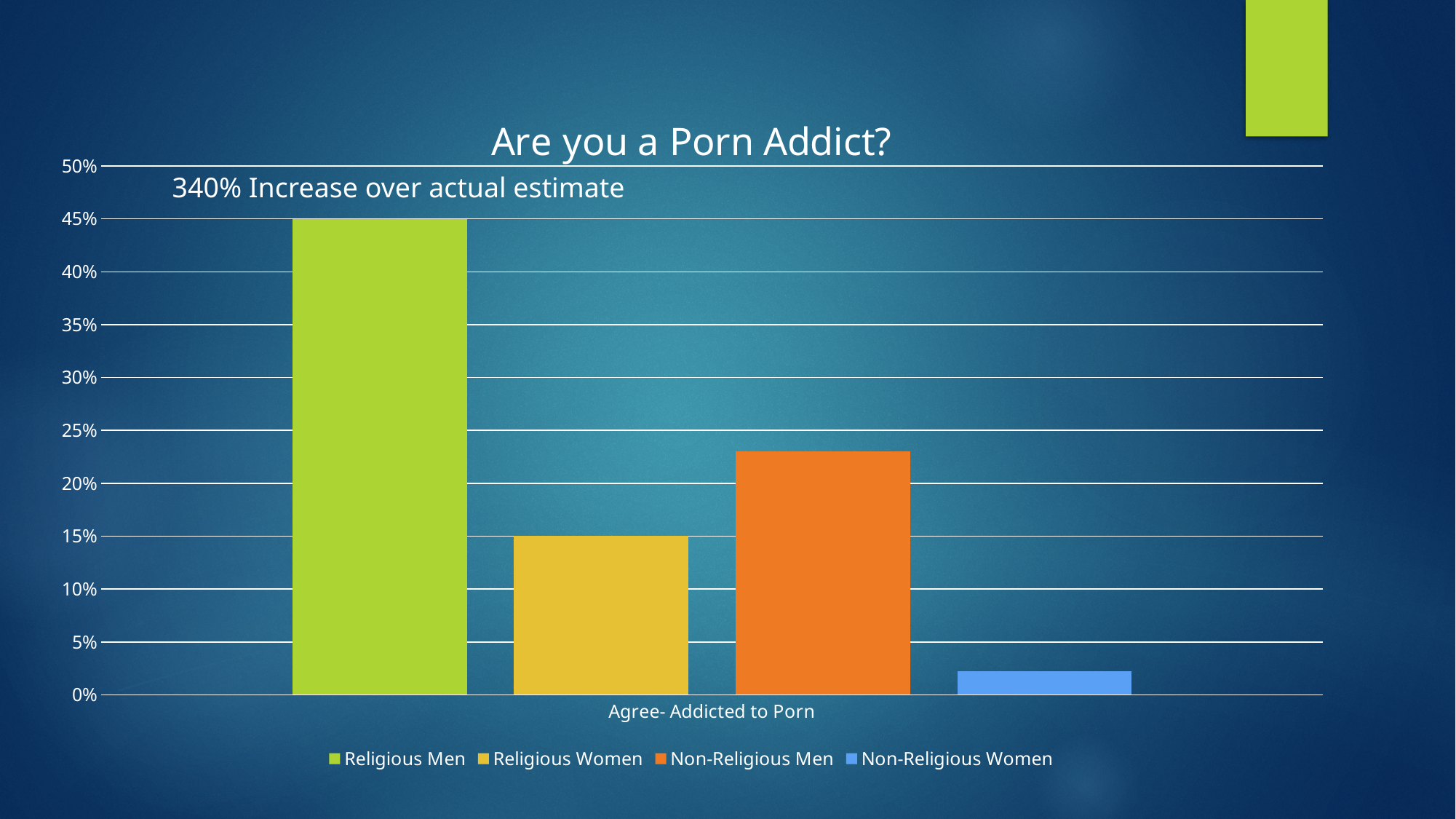
Which group has the lowest value in the chart? Non-Religious Women What is the title of the chart? Are you a Porn Addict? Which group has the highest value in the chart? Religious Men Is the value for Non-Religious Men greater or less than 20%? greater Is the value for Non-Religious Women greater or less than 5%? less How many series does the legend list? 4 What is the value for Religious Women in the chart? 15% What is the value for Religious Men in the chart? 45% What kind of chart is shown on the slide? Bar chart What is the difference between the values for Religious Men and Religious Women? 30% What is the label on the x axis category? Agree- Addicted to Porn Which is larger, the value for Non-Religious Men or the value for Religious Women? Non-Religious Men